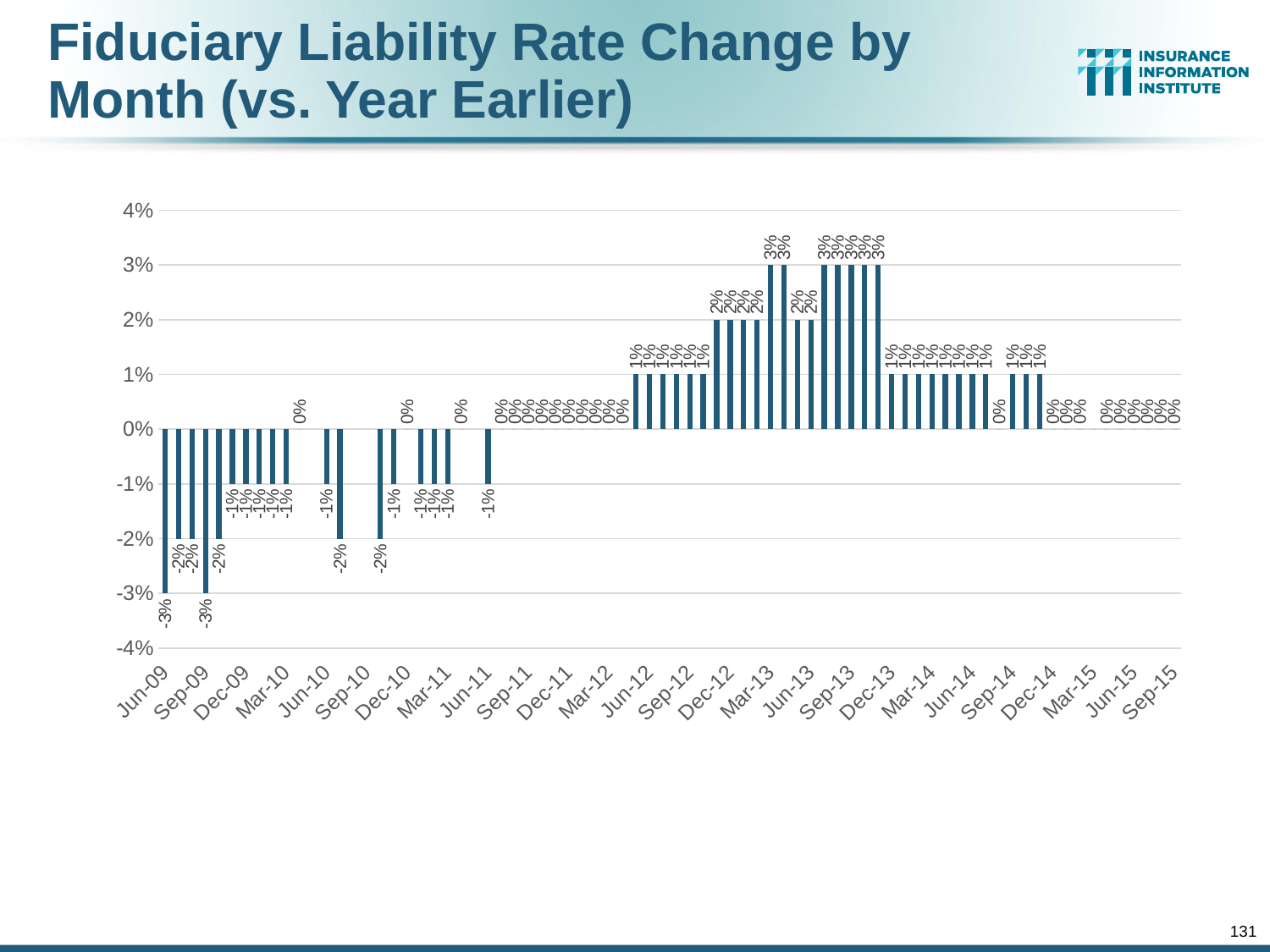
Do the values rise or fall from Jun-09 to Mar-10? rise What is the lowest rate change value labeled on the chart? -3% What is the highest value shown on the vertical axis? 4% What is the highest rate change value labeled on the chart? 3% What is the title of the chart? Fiduciary Liability Rate Change by Month (vs. Year Earlier) Which is larger, the rate change for Jun-09 or for Sep-15? Sep-15 What is the difference between the highest labeled value (3%) and the lowest labeled value (-3%)? 6 percentage points What is the rate change shown for Sep-09? -3% What kind of chart is shown on the slide? bar chart Is the value for Jun-09 greater or less than -2%? less What is the rate change shown for Jun-09? -3% What is the rate change shown for Sep-15? 0%